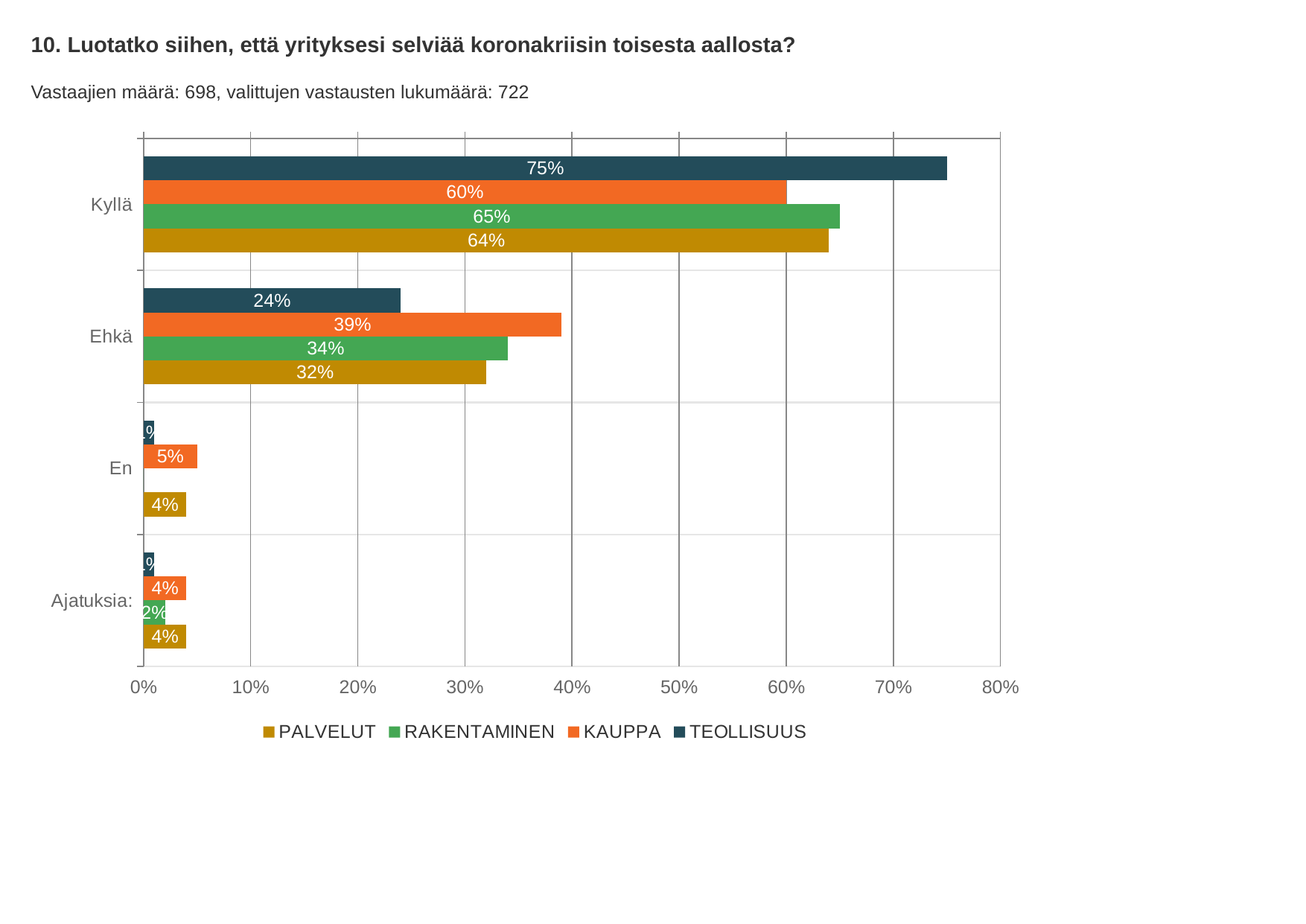
What is the value for TEOLLISUUS in the Kyllä category? 75% How many series does the legend list? 4 Which series has the highest value in the Kyllä category? TEOLLISUUS What is the difference between the KAUPPA and TEOLLISUUS values in the Ehkä category? 15% Which series has the lowest value in the Ehkä category? TEOLLISUUS Which series is shown in orange in the legend? KAUPPA What is the value for RAKENTAMINEN in the Ajatuksia: category? 2% What is the value for KAUPPA in the Ehkä category? 39% Which is larger in the Kyllä category: RAKENTAMINEN or KAUPPA? RAKENTAMINEN What kind of chart is shown on the slide? bar chart How many answer categories are shown on the vertical axis? 4 What is the value for PALVELUT in the Kyllä category? 64%